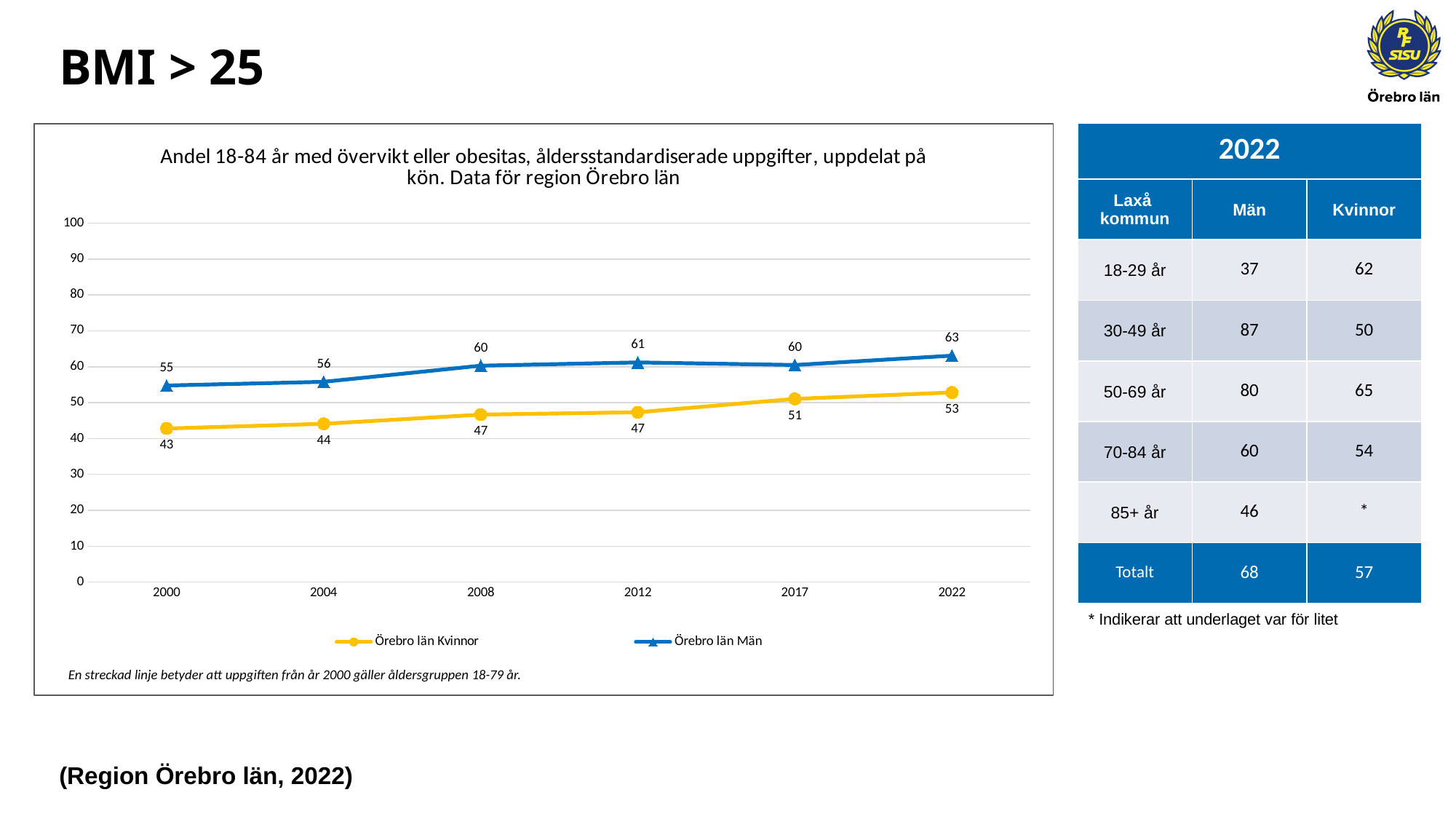
What type of chart is shown on the slide? Line chart How many years are shown on the x axis? 6 What is the value for Örebro län Män in 2022? 63 What is the value for Örebro län Kvinnor in 2017? 51 What is the difference between Örebro län Män and Örebro län Kvinnor in 2008? 13 How many series does the legend list? 2 Which series has the larger value in 2012, Örebro län Kvinnor or Örebro län Män? Örebro län Män In which year is the value for Örebro län Kvinnor lowest? 2000 What is the value for Örebro län Kvinnor in 2000? 43 In which year is the value for Örebro län Män highest? 2022 Which colour is used for the Örebro län Män line? Blue Does the value for Örebro län Kvinnor rise or fall from 2000 to 2022? Rise